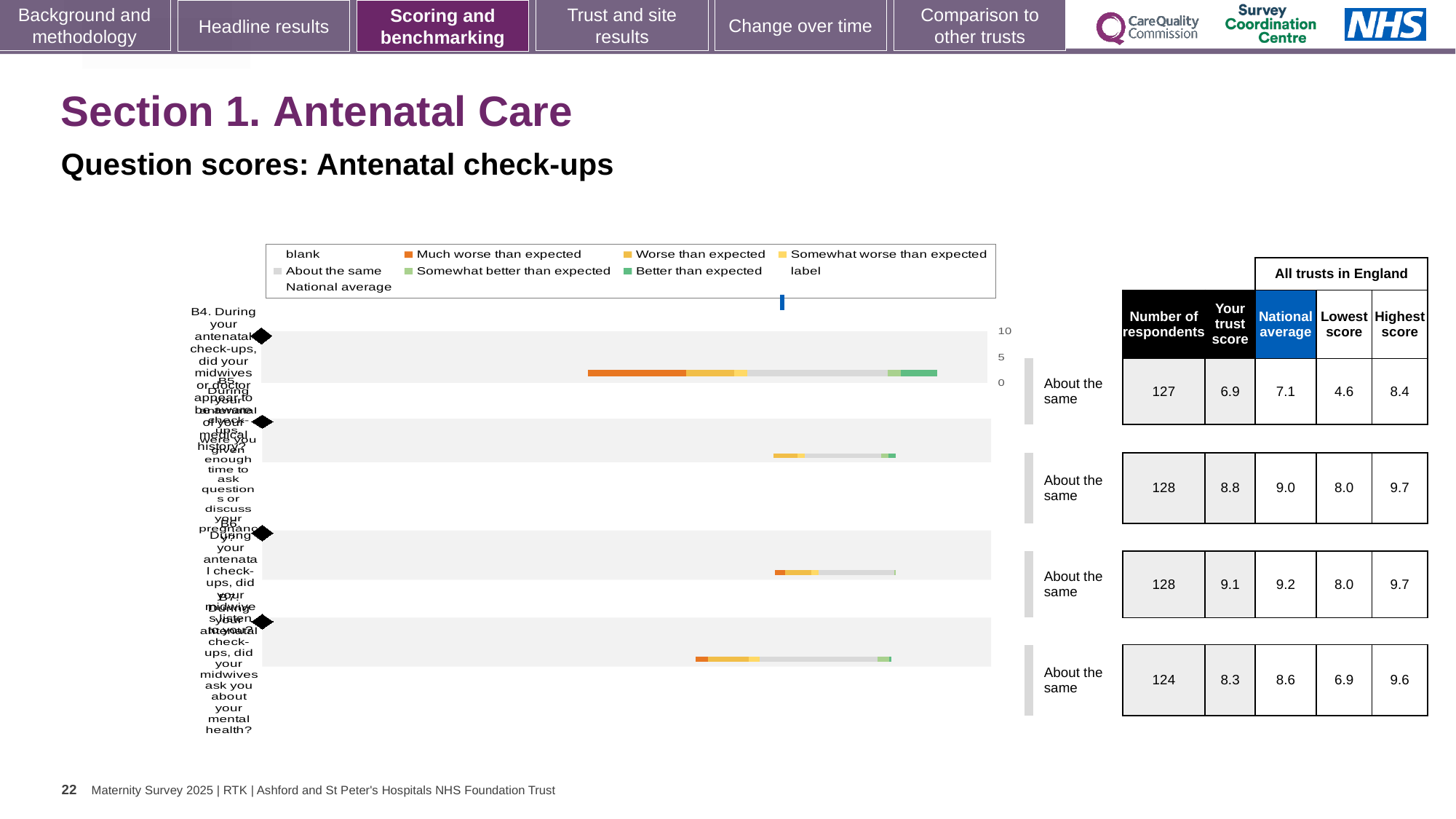
What is the difference between the national average and the trust score for question B4? 0.2 What is the lowest score among all trusts in England for question B7? 6.9 Which question (B4 to B7) has the lowest trust score? B4 What is the highest tick value shown on the chart's axis? 10 What kind of chart is shown on the slide? bar chart What is the national average for question B7? 8.6 Which question (B4 to B7) has the highest trust score? B6 What colour does the legend use for 'Much worse than expected'? orange What is the trust score for question B4 in the table beside the chart? 6.9 For question B5, which is larger: the trust score or the national average? national average How many question bars (B4 to B7) are plotted in the chart? 4 How many respondents answered question B7? 124